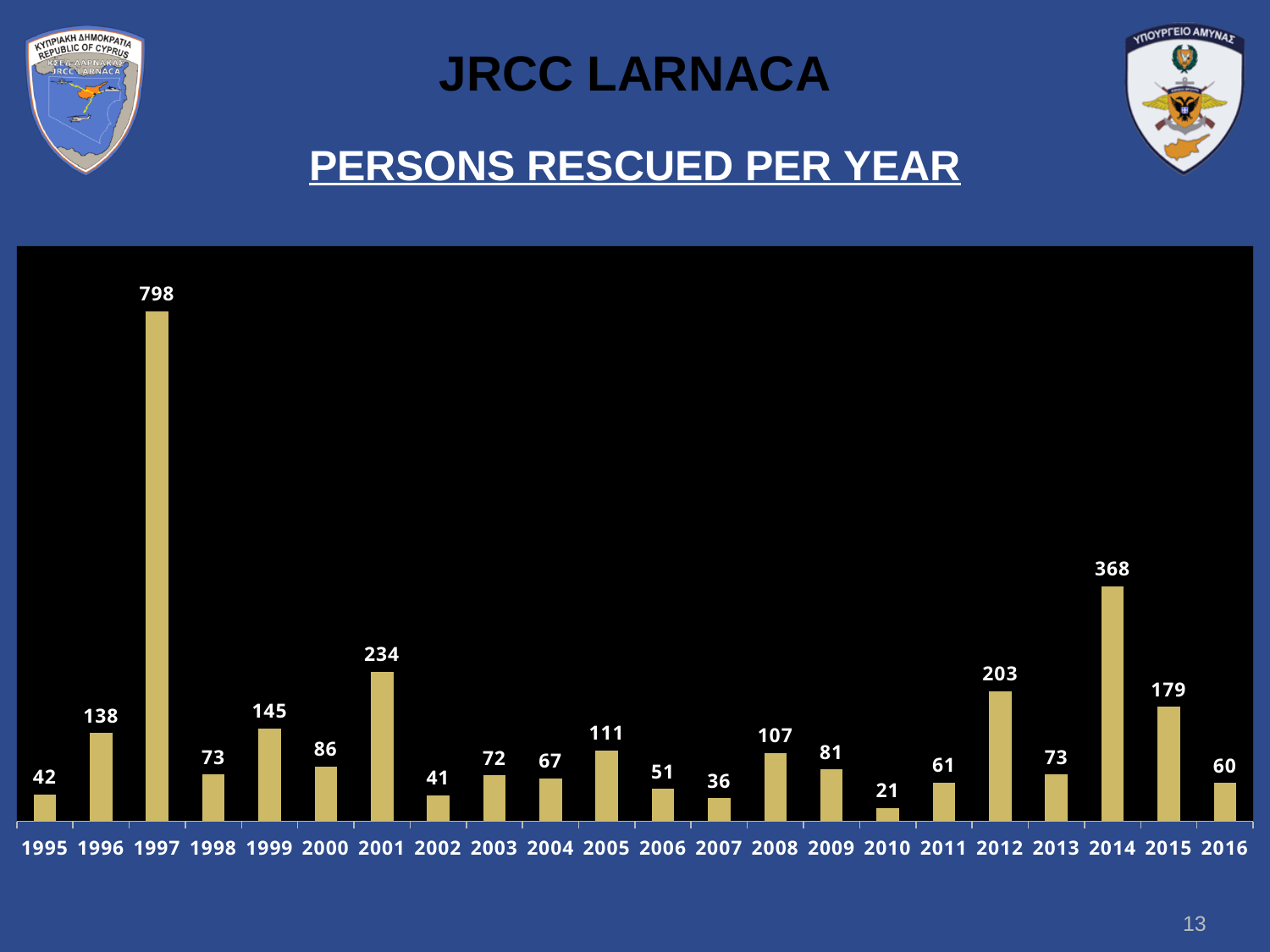
Which year has the lowest number of persons rescued? 2010 Which year had more persons rescued, 2008 or 2009? 2008 How many years are shown on the x axis of the chart? 22 Which year has the highest number of persons rescued? 1997 How many persons were rescued in 2014? 368 Which year had more persons rescued, 1996 or 1999? 1999 What is the value shown for 2010? 21 What type of chart is shown on the slide? Bar chart How many persons were rescued in 1997? 798 What is the difference between the persons rescued in 2014 and in 2015? 189 What is the title of the chart on the slide? PERSONS RESCUED PER YEAR What is the difference between the values for 2001 and 2012? 31